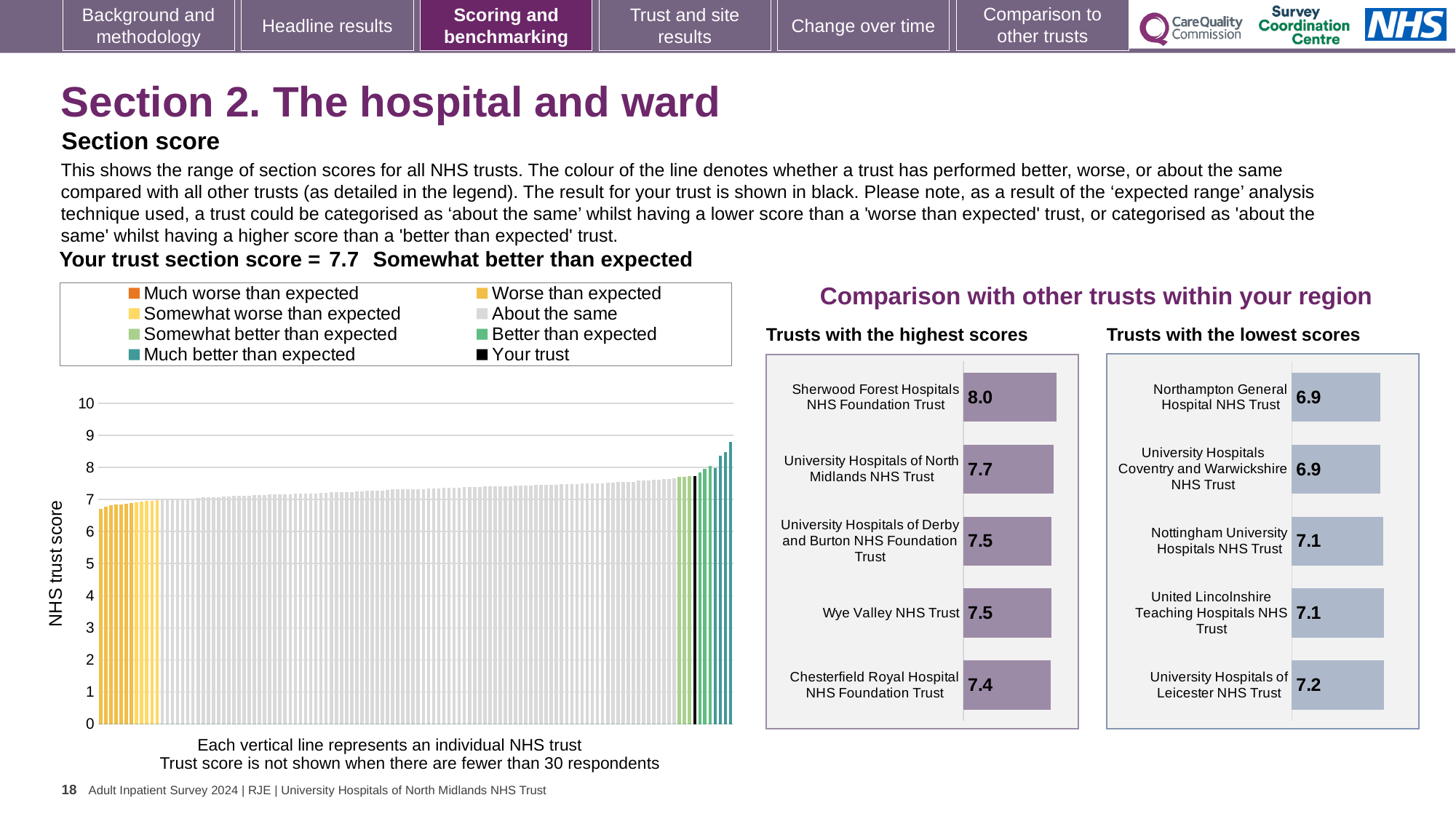
In the 'Trusts with the highest scores' chart, what is the score for Sherwood Forest Hospitals NHS Foundation Trust? 8.0 In the 'Trusts with the lowest scores' chart, what is the score for University Hospitals of Leicester NHS Trust? 7.2 In the 'Trusts with the highest scores' chart, what is the difference between the scores of Sherwood Forest Hospitals NHS Foundation Trust and Chesterfield Royal Hospital NHS Foundation Trust? 0.6 In the 'Trusts with the highest scores' chart, which trust has the highest score? Sherwood Forest Hospitals NHS Foundation Trust In the 'Trusts with the lowest scores' chart, which trust has the highest score? University Hospitals of Leicester NHS Trust In the 'Trusts with the highest scores' chart, what is the score for Chesterfield Royal Hospital NHS Foundation Trust? 7.4 How many trusts are shown in the 'Trusts with the highest scores' chart? 5 In the 'Trusts with the lowest scores' chart, which has the larger score: Nottingham University Hospitals NHS Trust or Northampton General Hospital NHS Trust? Nottingham University Hospitals NHS Trust In the main NHS trust score chart, is the value for the black 'Your trust' bar greater or less than 7? greater What is the y-axis label of the main chart on the left of the slide? NHS trust score How many entries does the legend of the main NHS trust score chart list? 8 What kind of chart is the 'Trusts with the lowest scores' chart? Bar chart